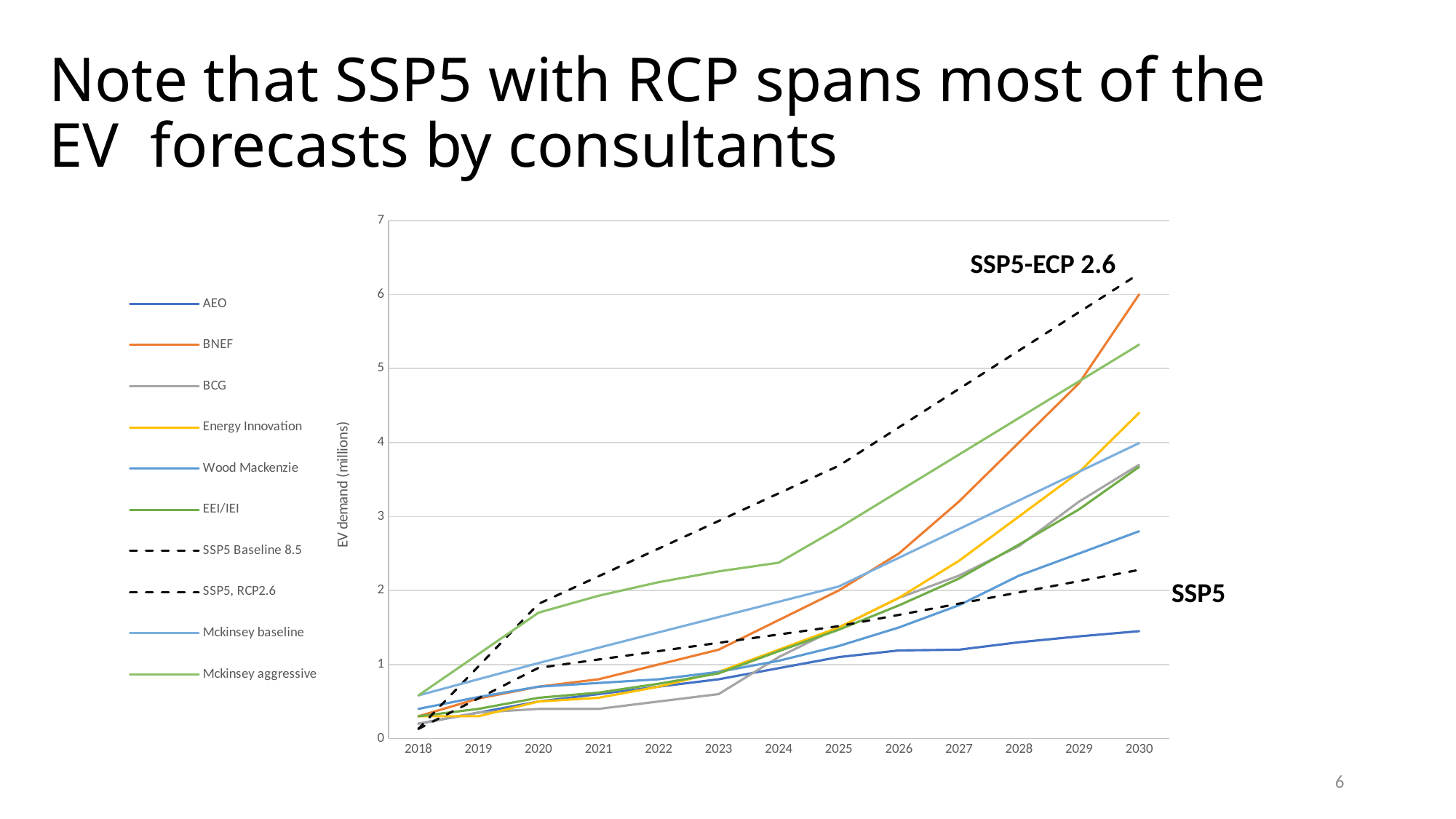
Among the solid (consultant) lines, which series is highest in 2030? BNEF Which series is lowest in 2030? AEO Is the value for Wood Mackenzie in 2030 greater or less than 3? less Is the value for AEO in 2030 greater or less than 2? less What kind of chart is shown on the slide? line chart How many series does the legend list? 10 What is the label of the y axis? EV demand (millions) Does the BNEF line rise or fall from 2018 to 2030? rise How many years are shown along the x axis? 13 Is the value for Mckinsey aggressive in 2030 greater or less than 5? greater Which two legend entries are drawn as dashed lines? SSP5 Baseline 8.5 and SSP5, RCP2.6 In 2030, which is larger, Mckinsey aggressive or Wood Mackenzie? Mckinsey aggressive